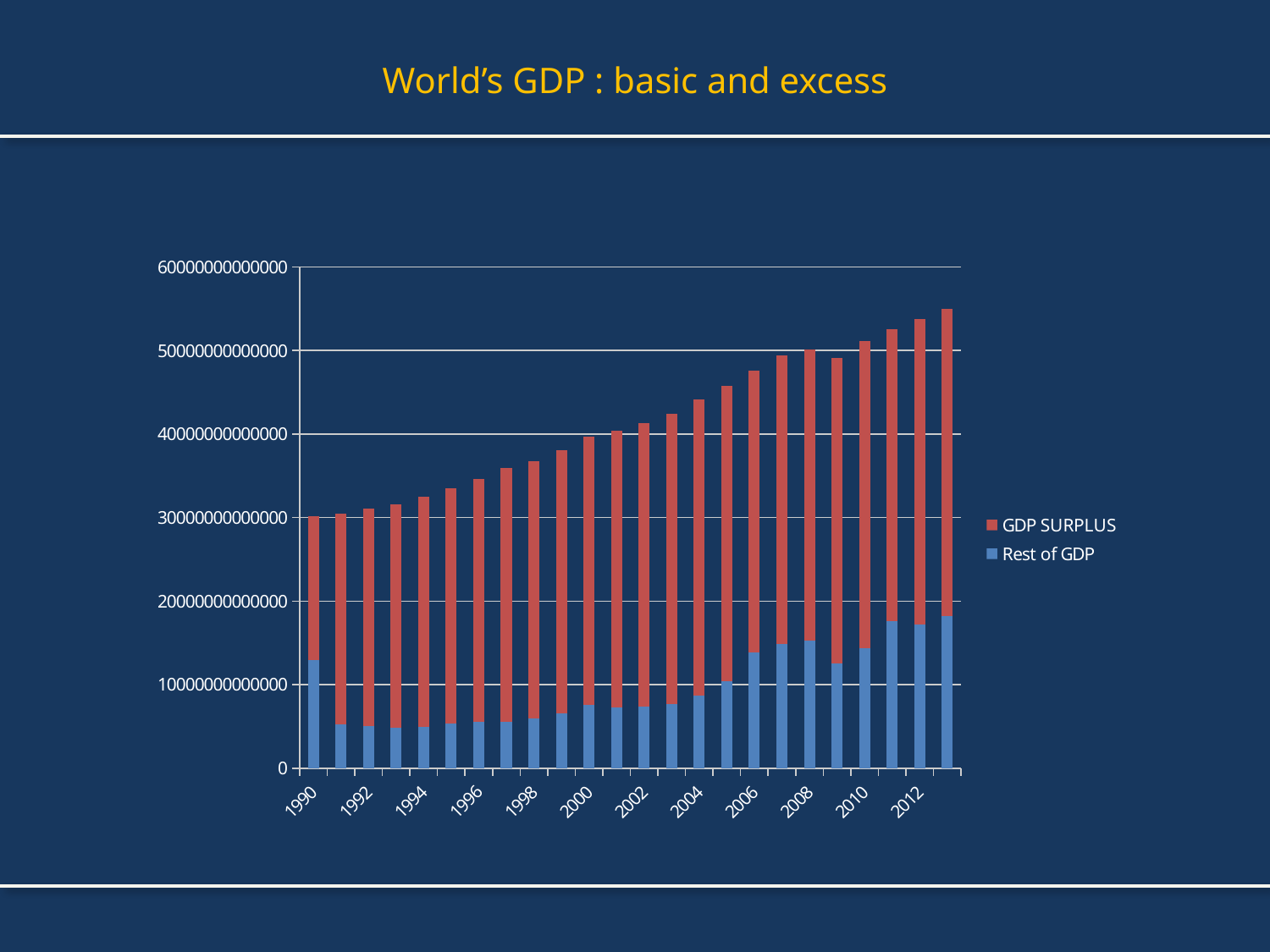
Is the total value for 2012 greater or less than 500000000000000? greater Which year has the larger Rest of GDP value, 2010 or 2011? 2011 Which year has the highest total bar? 2013 Do the total bar heights generally rise or fall from 1990 to 2013? Rise What kind of chart is shown on the slide? Stacked bar chart How many series does the legend list? 2 Which year has the lowest total bar? 1990 What are the two series named in the legend? GDP SURPLUS and Rest of GDP What is the title of the chart? World's GDP : basic and excess Is the total value for 1996 greater or less than 300000000000000? greater Is the Rest of GDP value for 2013 greater or less than 200000000000000? less How many years (bars) are plotted on the chart? 24